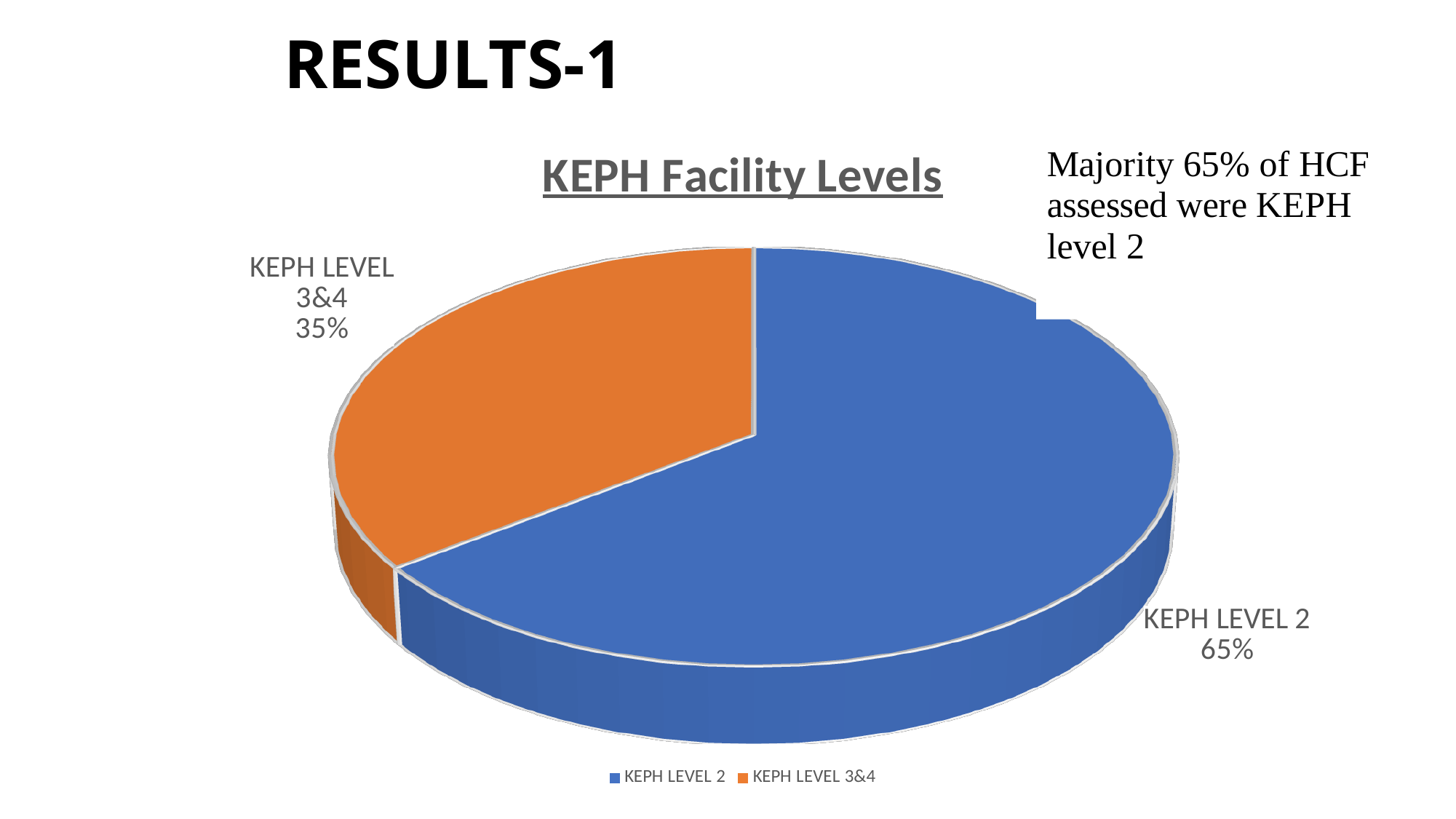
What share of the pie does KEPH LEVEL 3&4 represent? 35% What is the difference in percentage points between the KEPH LEVEL 2 and KEPH LEVEL 3&4 slices? 30 What colour is the KEPH LEVEL 3&4 slice? Orange How many entries does the legend list? 2 How many categories are shown in the pie chart? 2 Which category has the largest slice of the pie? KEPH LEVEL 2 What share of the pie does KEPH LEVEL 2 represent? 65% What is the title of the chart? KEPH Facility Levels What kind of chart is shown on the slide? Pie chart Which slice is larger, KEPH LEVEL 2 or KEPH LEVEL 3&4? KEPH LEVEL 2 Which category has the smallest slice of the pie? KEPH LEVEL 3&4